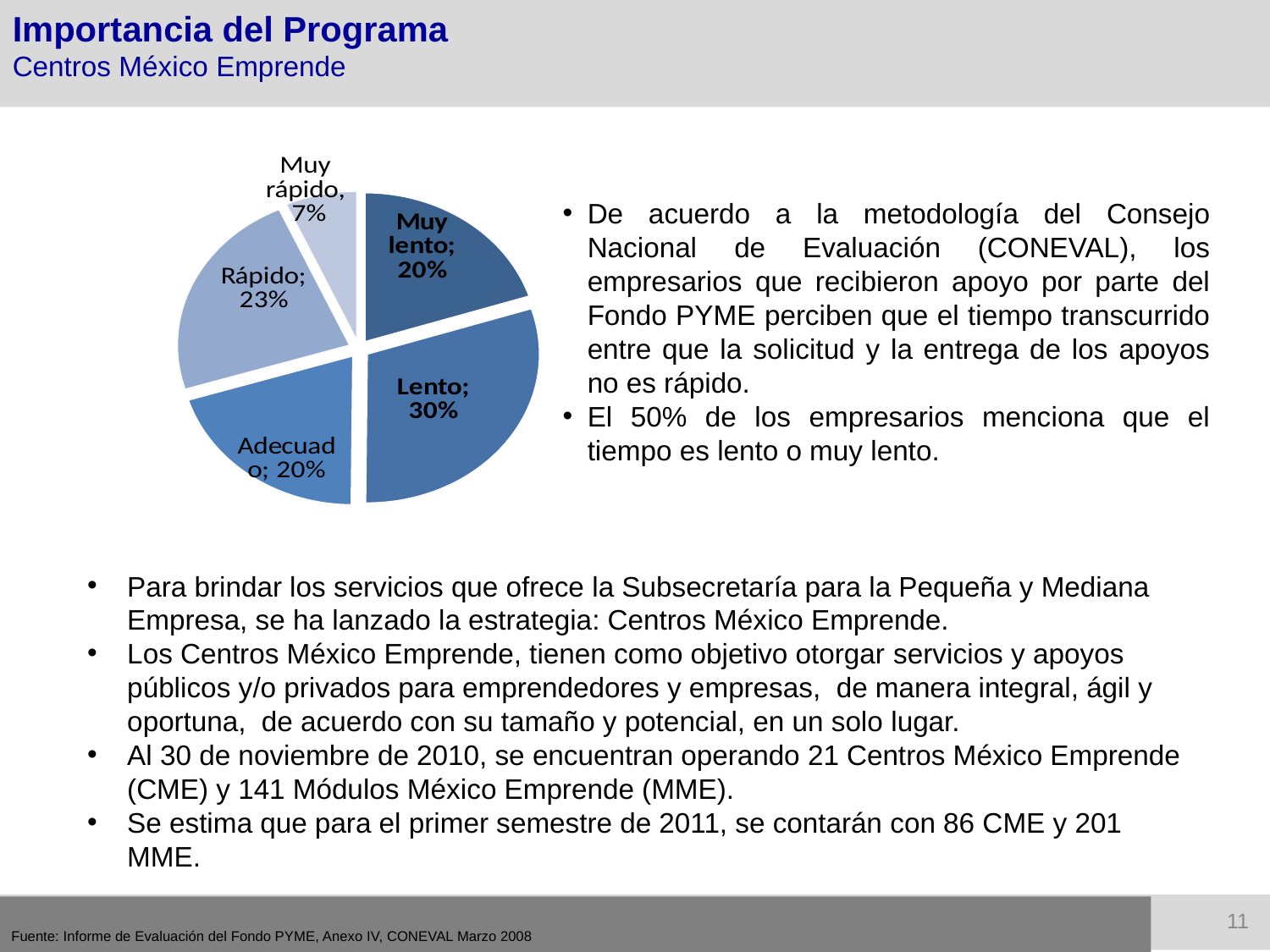
Which is larger, the "Rápido" slice or the "Muy lento" slice? Rápido What is the value shown for "Muy rápido"? 7% What is the combined share of the "Lento" and "Muy lento" slices? 50% What is the value shown for "Rápido"? 23% What percentage of the pie does the "Lento" slice represent? 30% How many slices does the pie chart have? 5 Which slice of the pie chart is the largest? Lento Which two categories in the pie chart have the same value of 20%? Muy lento and Adecuado What is the difference between the "Lento" and "Muy rápido" slices? 23% What kind of chart is shown on the slide? pie chart Which slice of the pie chart is the smallest? Muy rápido What is the value shown for "Adecuado"? 20%